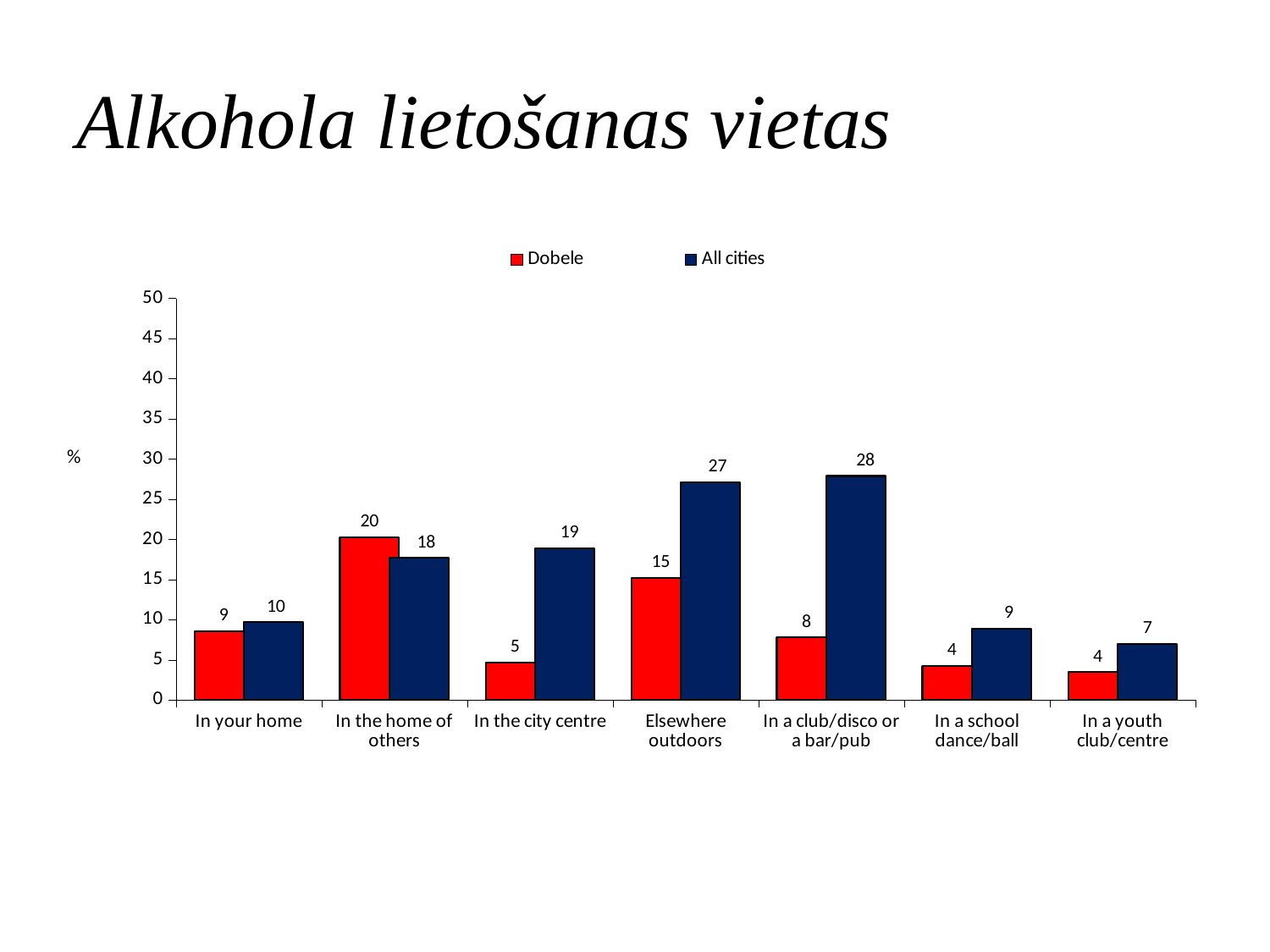
What is the Dobele value for "In the home of others"? 20 What is the All cities value for "In a club/disco or a bar/pub"? 28 Which is larger for "In the home of others": the Dobele value or the All cities value? Dobele Which category has the highest Dobele value? In the home of others What is the difference between the All cities and Dobele values for "Elsewhere outdoors"? 12 Which category has the highest All cities value? In a club/disco or a bar/pub Is the All cities value for "Elsewhere outdoors" greater or less than 25? greater What is the Dobele value for "In the city centre"? 5 What kind of chart is shown on the slide? Bar chart How many categories are shown on the x axis? 7 Which colour represents the Dobele series? Red How many series does the legend list? 2